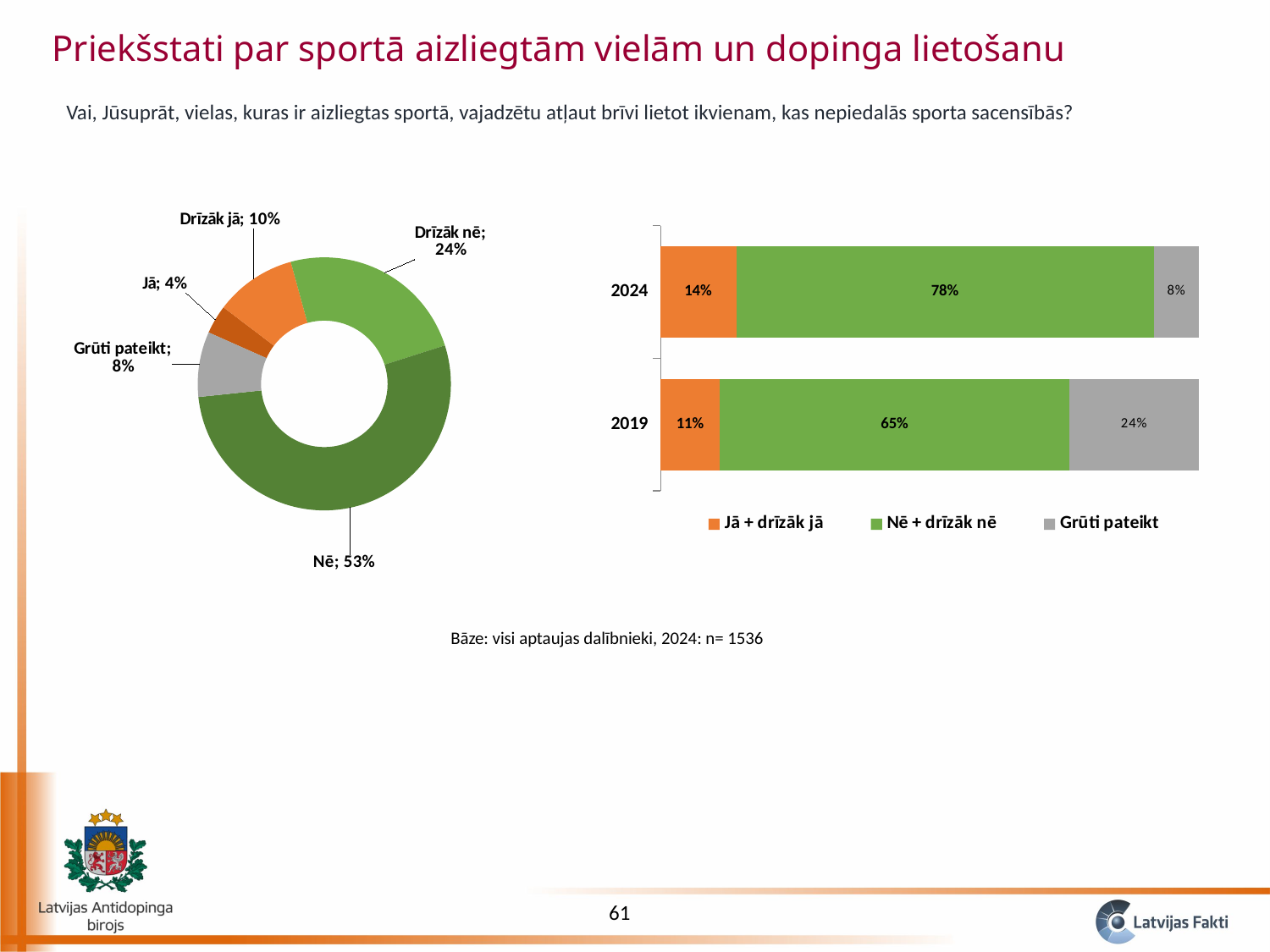
What kind of chart is shown on the right side of the slide? Stacked horizontal bar chart In the doughnut chart on the left, what share of respondents answered "Nē"? 53% In the doughnut chart on the left, which answer has the smallest share? Jā In the bar chart on the right, what is the value of "Nē + drīzāk nē" for 2024? 78% In the doughnut chart on the left, what is the difference between the shares for "Drīzāk nē" and "Drīzāk jā"? 14 percentage points In the bar chart on the right, which year has the larger value for "Jā + drīzāk jā", 2024 or 2019? 2024 In the doughnut chart on the left, what share of respondents answered "Jā"? 4% In the bar chart on the right, by how many percentage points did "Nē + drīzāk nē" change from 2019 to 2024? 13 percentage points In the doughnut chart on the left, how many slices are there? 5 In the bar chart on the right, what is the value of "Grūti pateikt" for 2019? 24% In the doughnut chart on the left, which answer has the largest share? Nē In the bar chart on the right, how many series does the legend list? 3